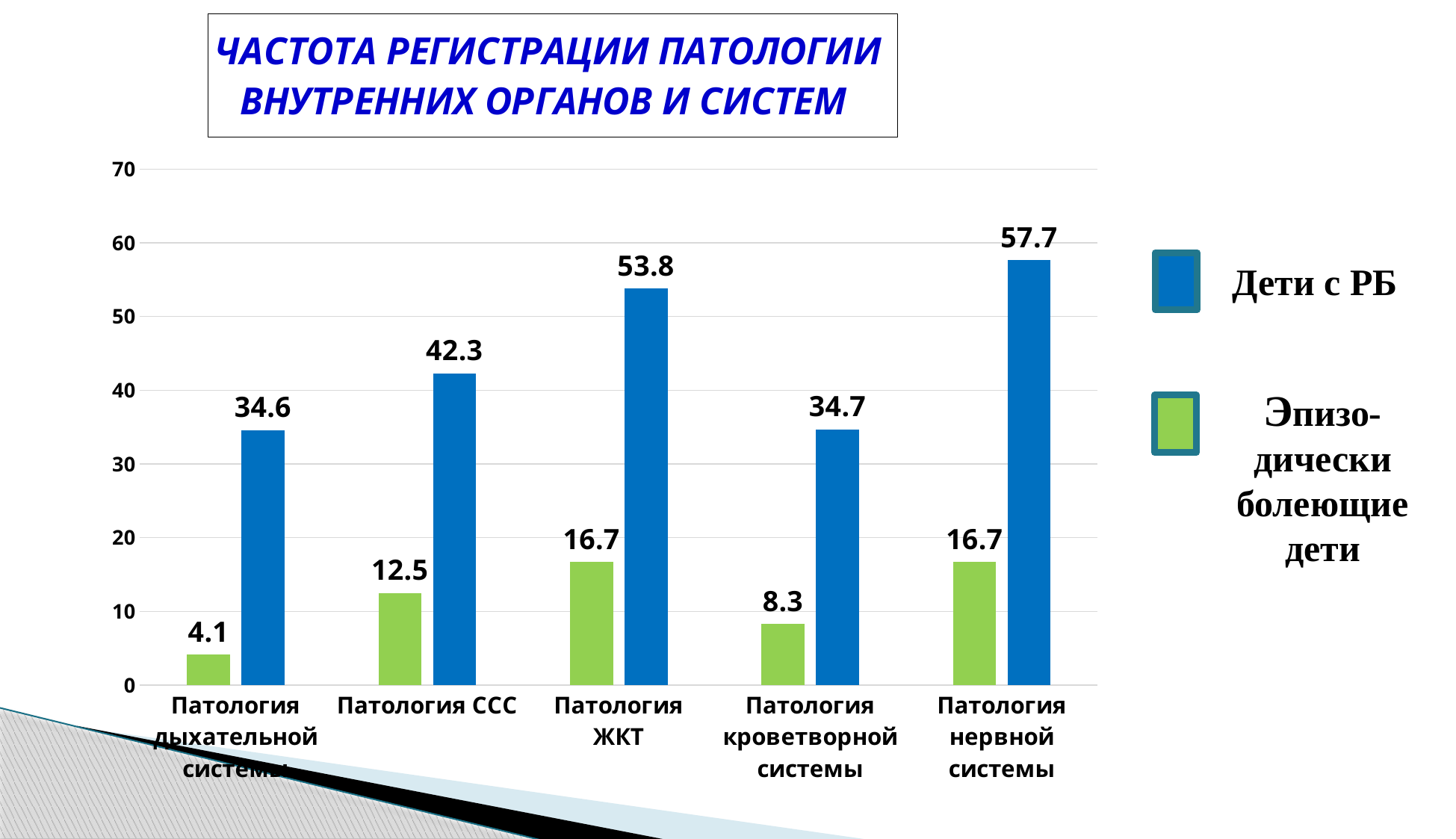
Which category has the lowest value for Эпизодически болеющие дети? Патология дыхательной системы What is the value for Эпизодически болеющие дети in the Патология ССС category? 12.5 What is the value for Дети с РБ in the Патология ЖКТ category? 53.8 How many categories are shown on the x axis? 5 What is the value for Эпизодически болеющие дети in the Патология кроветворной системы category? 8.3 Is the value for Дети с РБ in the Патология дыхательной системы category greater or less than 30? greater Which category has the highest value for Дети с РБ? Патология нервной системы What colour represents the Дети с РБ series? blue Which is larger: the Дети с РБ value for Патология ССС or for Патология кроветворной системы? Патология ССС How many series does the legend list? 2 What kind of chart is shown on the slide? bar chart What is the difference between the Дети с РБ and Эпизодически болеющие дети values in the Патология нервной системы category? 41.0